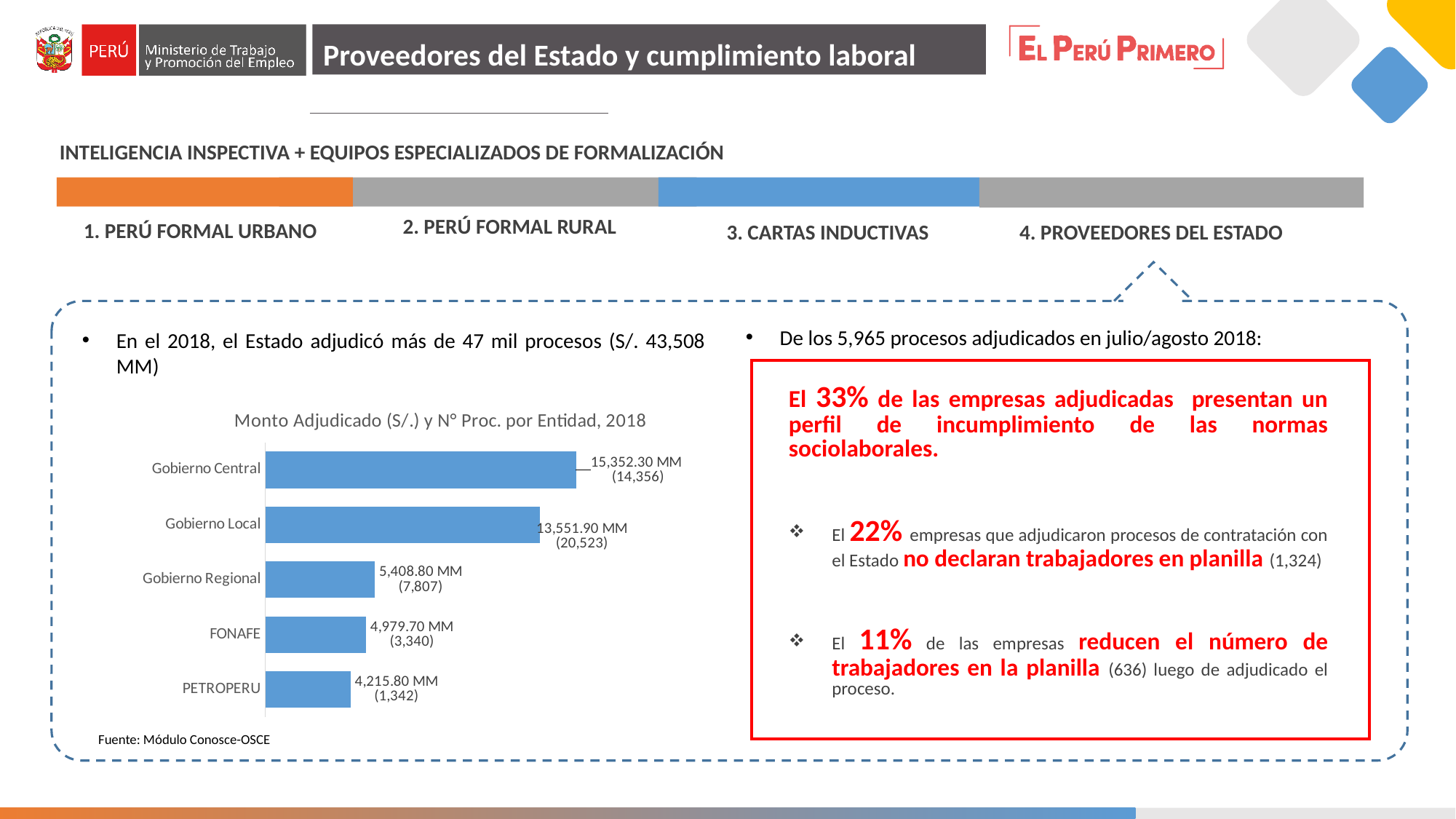
What kind of chart is shown on the slide? Bar chart What is the title of the chart on the slide? Monto Adjudicado (S/.) y N° Proc. por Entidad, 2018 Which entity has the lowest amount awarded in the chart? PETROPERU What is the amount awarded for Gobierno Local? 13,551.90 MM What is the amount awarded for PETROPERU? 4,215.80 MM How many entities (categories) are shown in the chart? 5 Which entity has the highest amount awarded in the chart? Gobierno Central What is the amount awarded (Monto Adjudicado) for Gobierno Central? 15,352.30 MM How many processes are shown in parentheses for FONAFE? 3,340 Which has a larger amount awarded, Gobierno Regional or FONAFE? Gobierno Regional What is the difference in amount awarded between Gobierno Central and Gobierno Local? 1,800.40 MM How many processes (N° Proc.) are shown in parentheses for Gobierno Local? 20,523